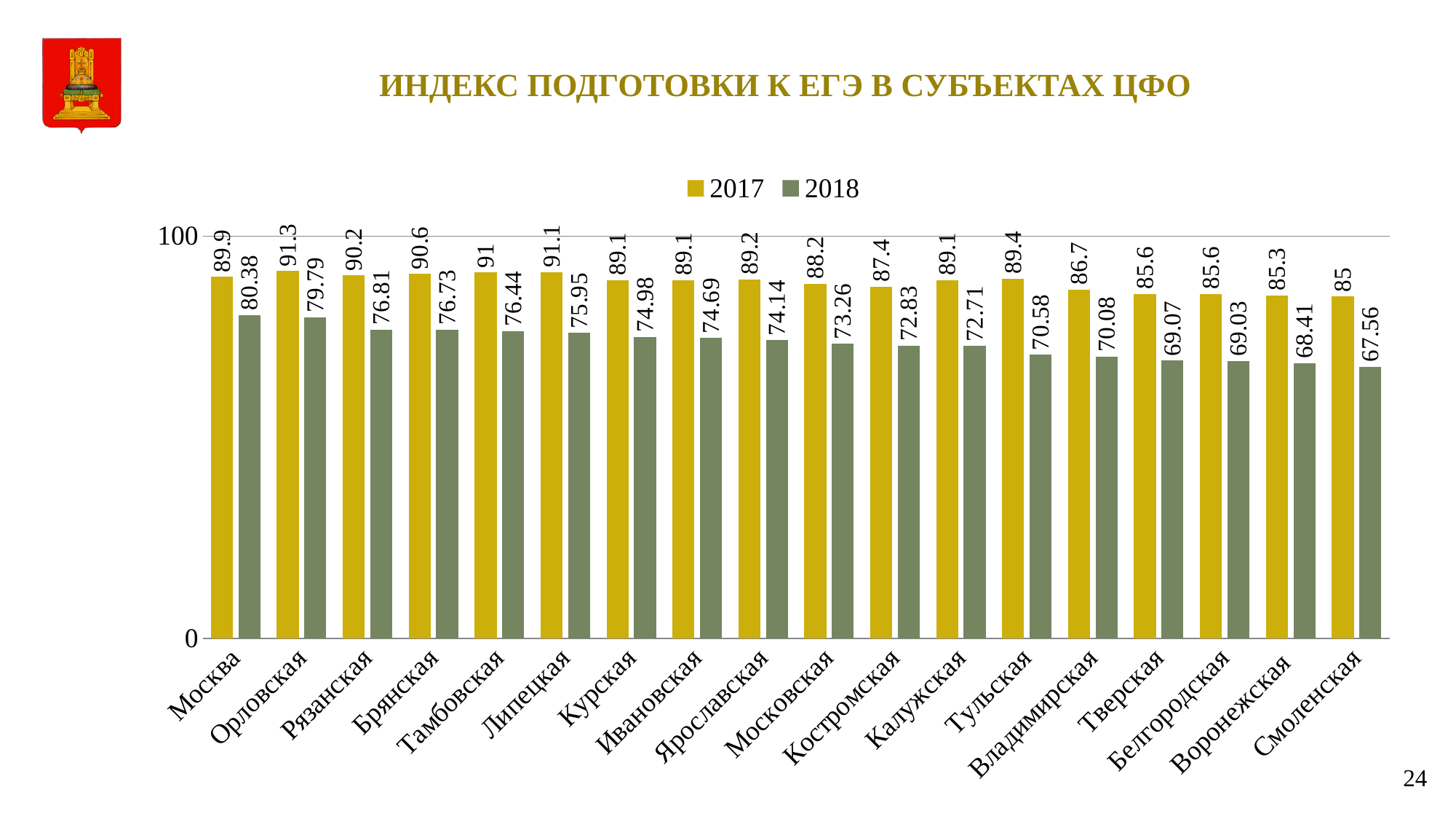
What kind of chart is shown on the slide? bar chart How many series does the legend list? 2 What is the 2018 value for Смоленская? 67.56 Which region has the highest 2018 value? Москва Do the 2018 values rise or fall from left to right along the x axis? fall How many regions are shown on the x axis? 18 What is the 2018 value for Москва? 80.38 What is the 2017 value for Тверская? 85.6 Which is larger for Тульская: the 2017 value or the 2018 value? 2017 Which region has the lowest 2018 value? Смоленская What is the difference between the 2017 and 2018 values for Москва? 9.52 Which region has the highest 2017 value? Орловская